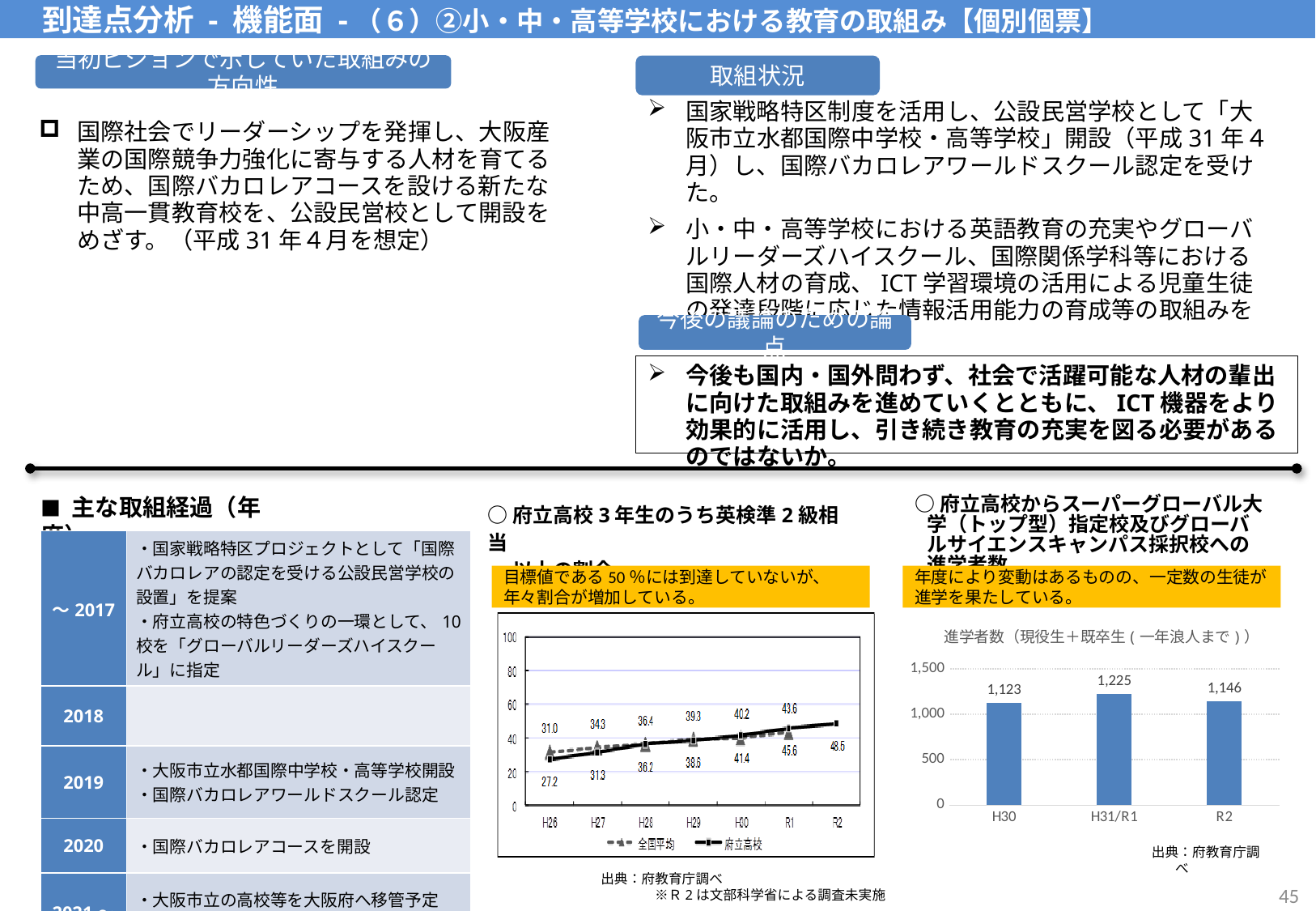
In the bar chart on the right (進学者数), which year has the highest value? H31/R1 In the bar chart on the right (進学者数), which year has the lowest value? H30 In the line chart in the middle (英検準2級相当以上の割合), what is the value for 府立高校 at R2? 48.5 In the line chart in the middle (英検準2級相当以上の割合), how many x-axis categories are shown? 7 In the line chart in the middle (英検準2級相当以上の割合), what is the value for 全国平均 at H26? 31.0 In the line chart in the middle (英検準2級相当以上の割合), how many series does the legend list? 2 What kind of chart is the chart on the right (進学者数)? bar chart In the line chart in the middle (英検準2級相当以上の割合), do the 府立高校 values rise or fall from H26 to R2? rise In the bar chart on the right (進学者数), how many bars are plotted? 3 In the bar chart on the right (進学者数), what is the value for H31/R1? 1,225 In the bar chart on the right (進学者数), what is the value for H30? 1,123 In the bar chart on the right (進学者数), what is the difference between the H31/R1 value and the R2 value? 79